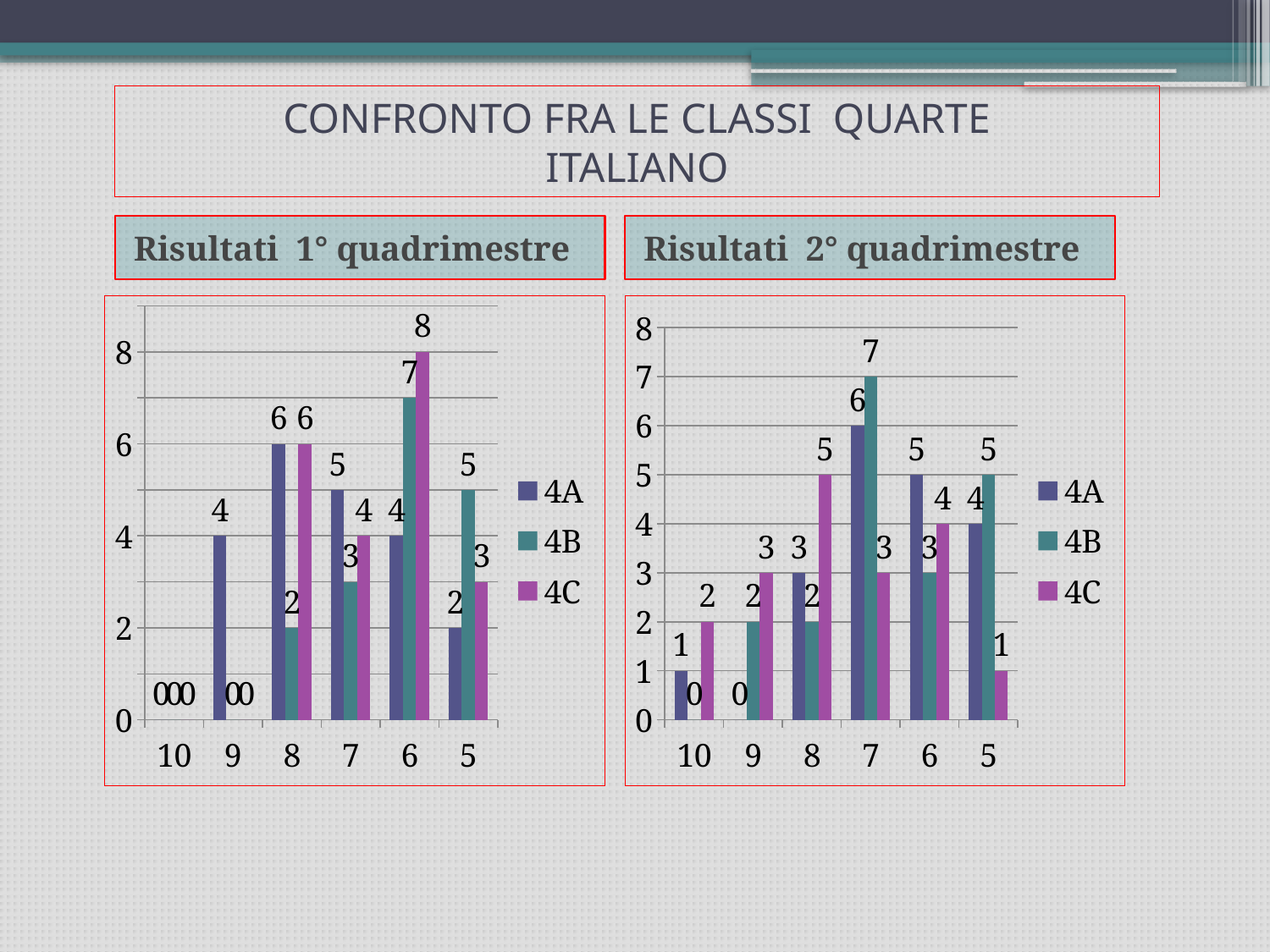
In the 'Risultati 2° quadrimestre' chart, which category has the lowest value for 4C? 5 In the 'Risultati 1° quadrimestre' chart, what is the value for 4C at category 6? 8 In the 'Risultati 1° quadrimestre' chart, which category has the highest value for 4A? 8 In the 'Risultati 2° quadrimestre' chart, which is larger at category 6: 4A or 4B? 4A How many categories are shown on the x axis of the 'Risultati 1° quadrimestre' chart? 6 What type of chart is the 'Risultati 1° quadrimestre' chart? Bar chart In the 'Risultati 2° quadrimestre' chart, what is the difference between the 4A values at category 7 and category 8? 3 In the 'Risultati 2° quadrimestre' chart, what is the value for 4C at category 8? 5 In the 'Risultati 1° quadrimestre' chart, what is the difference between the 4C and 4B values at category 6? 1 In the 'Risultati 1° quadrimestre' chart, what is the value for 4B at category 5? 5 In the 'Risultati 2° quadrimestre' chart, what is the value for 4B at category 7? 7 How many series does the legend of the 'Risultati 2° quadrimestre' chart list? 3